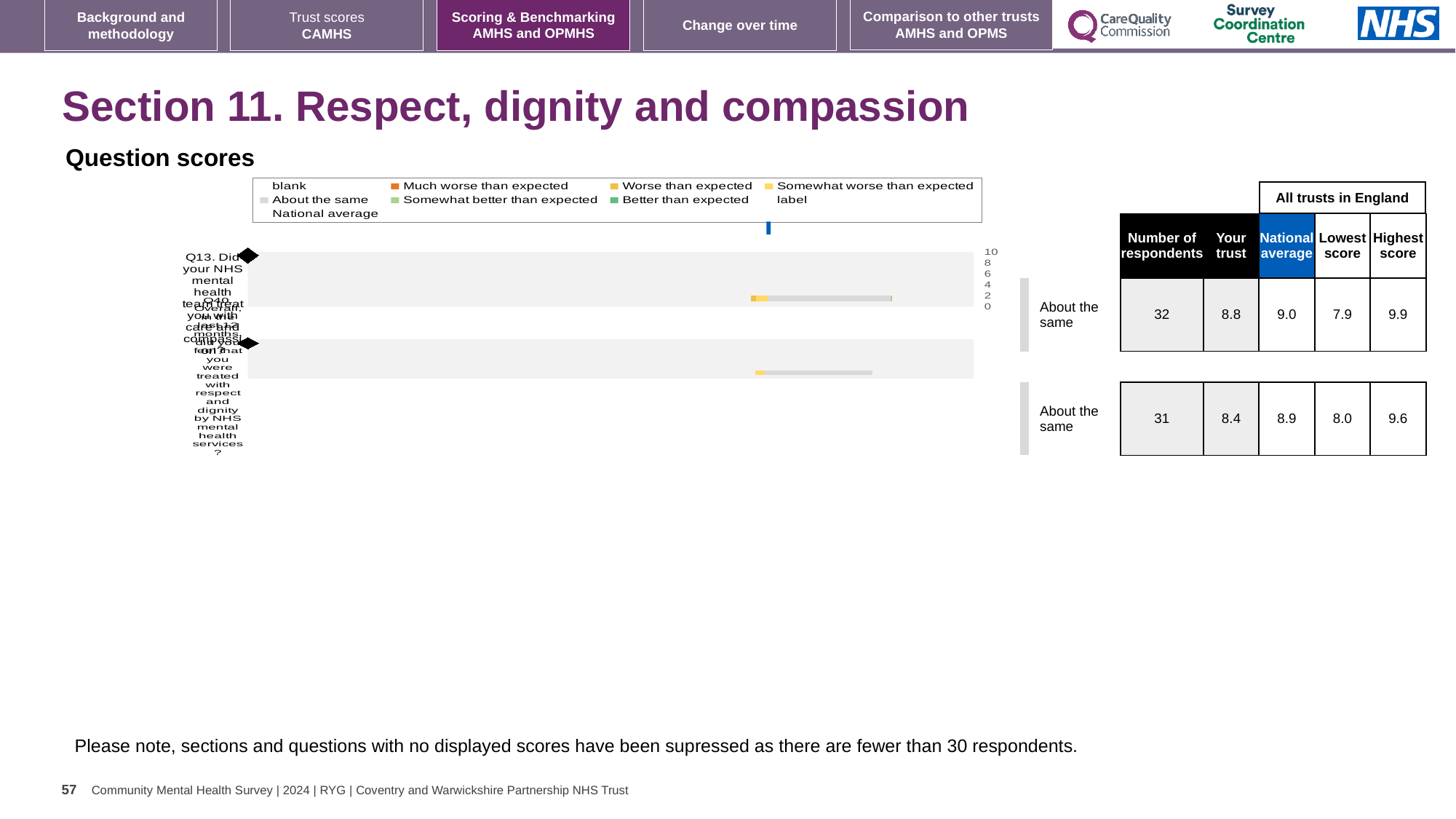
In the table next to the chart, what is the 'Your trust' score for the bottom row? 8.4 What rating category is shown beside both rows of the chart? About the same In the table next to the chart, what is the national average for the top row? 9.0 In the table next to the chart, what is the 'Your trust' score for the top row? 8.8 In the table next to the chart, what is the lowest score for the bottom row? 8.0 In the table next to the chart, what is the number of respondents for the top row? 32 What kind of chart is shown under 'Question scores'? bar chart How many questions (bars) are plotted in the chart? 2 What colour does the legend use for 'Much worse than expected'? Orange For the bottom row of the table, which is larger: the 'Your trust' score or the national average? National average In the table next to the chart, what is the highest score for the top row? 9.9 For the top row of the table, what is the difference between the national average and the 'Your trust' score? 0.2